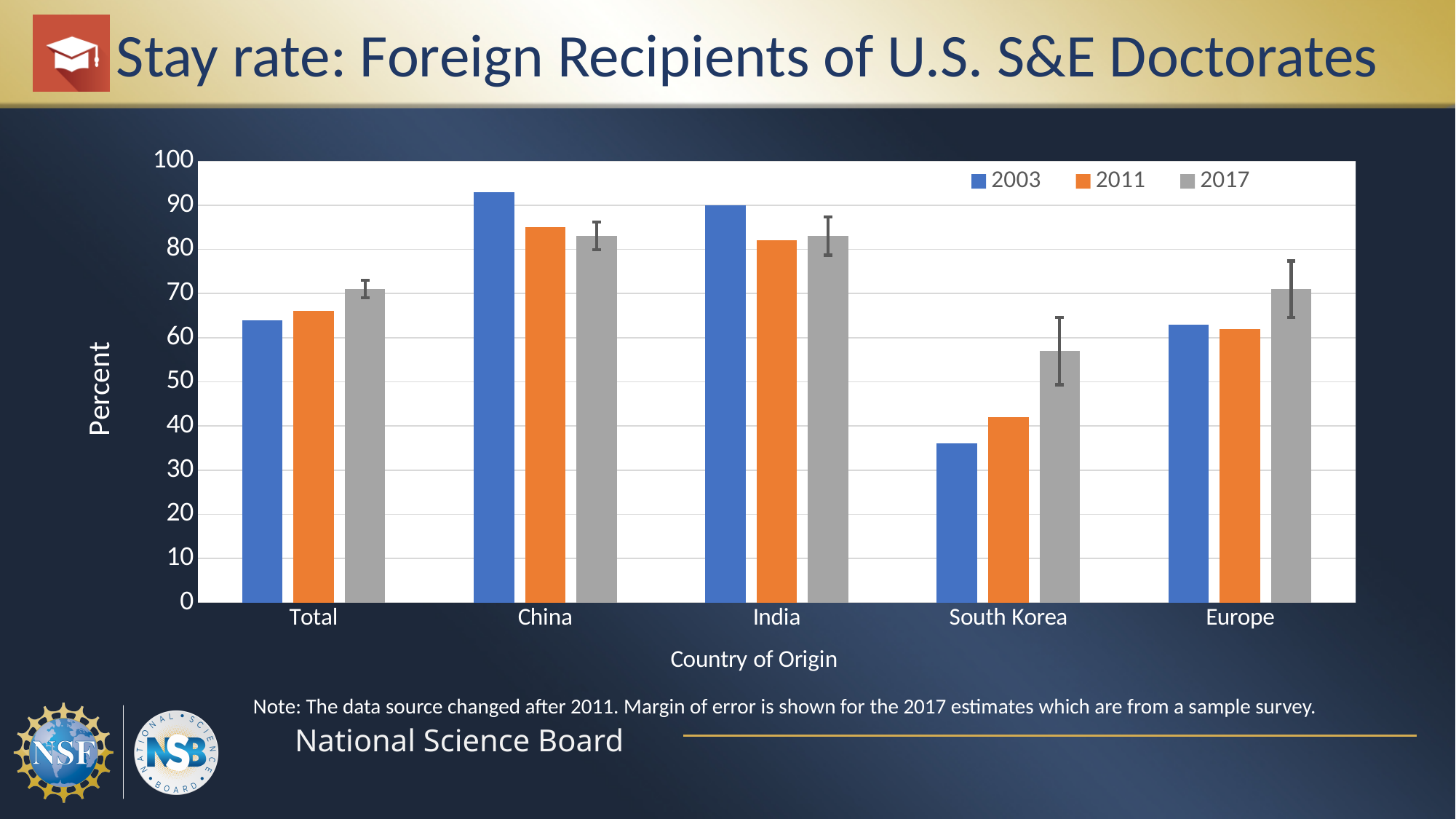
What is the label on the y axis of the chart? Percent Which country of origin has the lowest 2003 stay rate? South Korea Which country of origin has the lowest 2017 stay rate? South Korea How many series does the legend list? 3 Which is larger, the 2011 stay rate for China or the 2011 stay rate for India? China Is the 2003 stay rate for South Korea greater or less than 40? less What kind of chart is shown on the slide? bar chart How many countries of origin are shown on the x axis? 5 Which country of origin has the highest 2003 stay rate? China Is the 2003 stay rate for China greater or less than 90? greater Do the stay rates for South Korea rise or fall from 2003 to 2017? rise